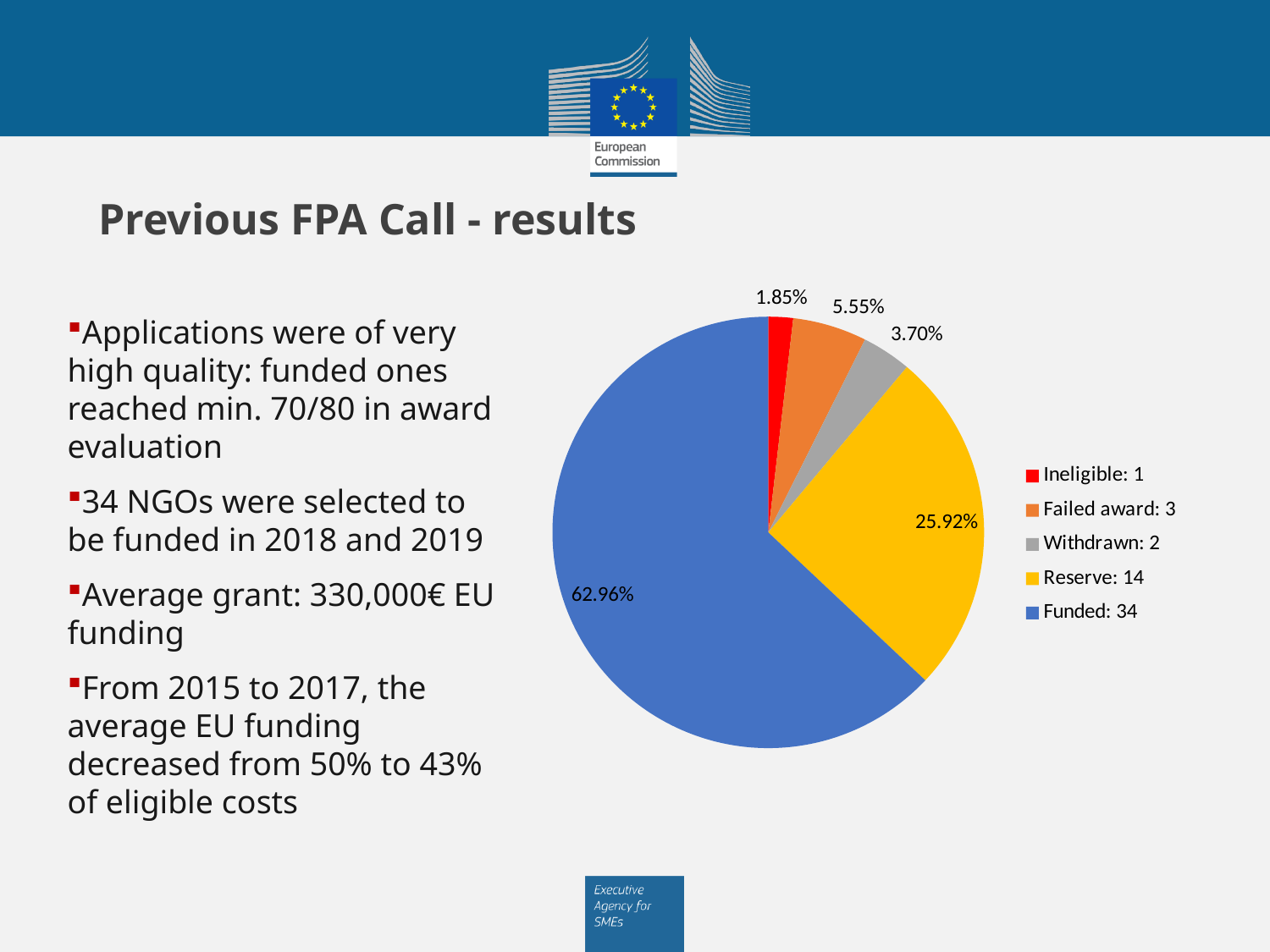
What colour is the Funded slice in the pie chart? blue How many categories does the pie chart show? 5 Which slice is larger, Failed award or Withdrawn? Failed award According to the legend, how many applications were in the Reserve category? 14 What kind of chart is shown on the slide? pie chart What percentage share does the Failed award slice have in the pie chart? 5.55% What percentage share does the Withdrawn slice have in the pie chart? 3.70% What percentage share does the Funded slice have in the pie chart? 62.96% Which category has the largest slice in the pie chart? Funded Which category has the smallest slice in the pie chart? Ineligible